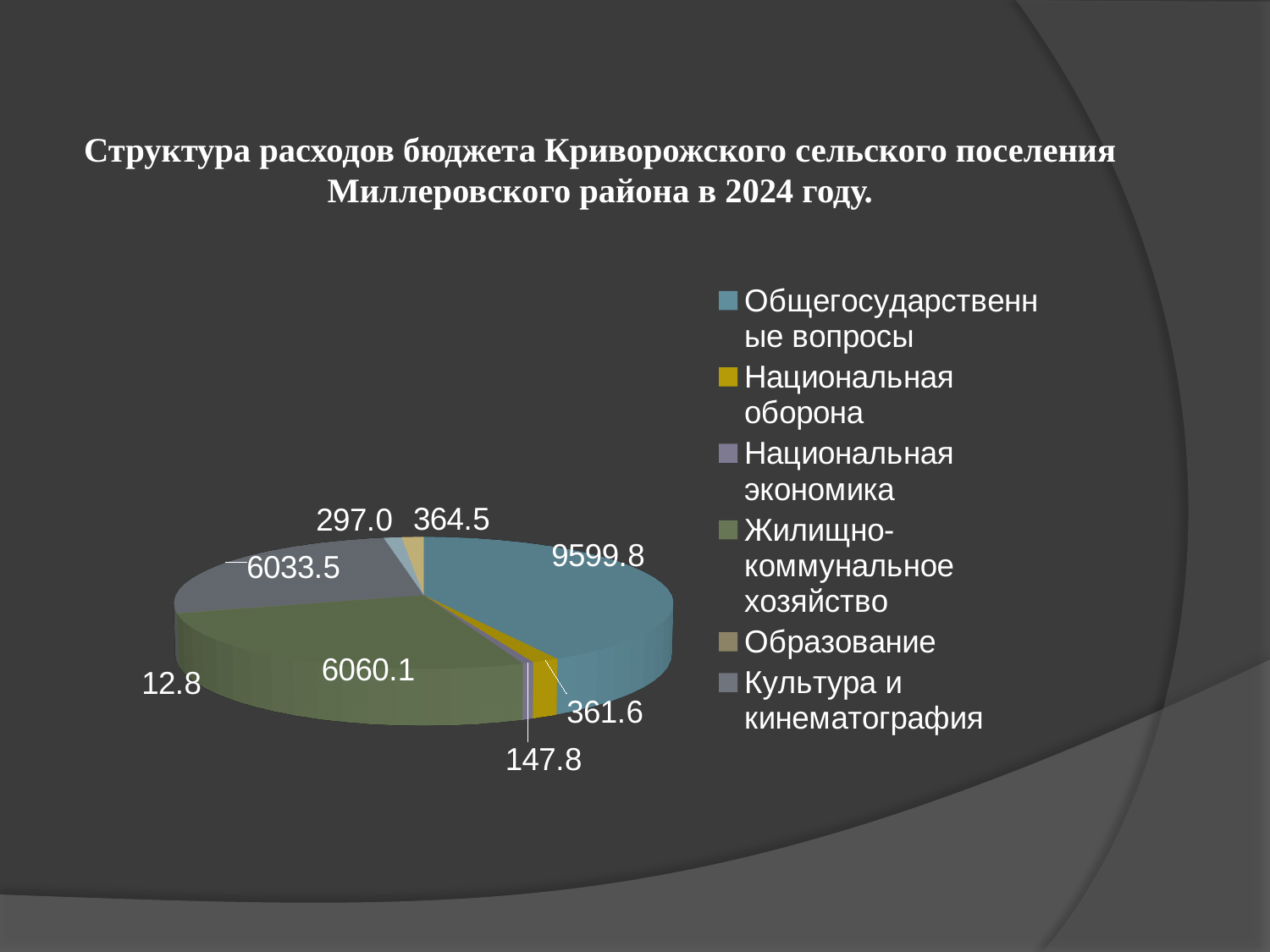
What is the value for Культура и кинематография? 6033.5 Which is larger, the value for Жилищно-коммунальное хозяйство or the value for Культура и кинематография? Жилищно-коммунальное хозяйство What type of chart is shown on the slide? Pie chart What is the value for Национальная оборона? 361.6 What is the value for Жилищно-коммунальное хозяйство? 6060.1 What is the difference between the values for Общегосударственные вопросы and Жилищно-коммунальное хозяйство? 3539.7 What is the value for Национальная экономика? 147.8 What is the value for Общегосударственные вопросы? 9599.8 How many data labels are shown on the pie chart? 8 How many entries does the legend list? 6 Which category has the largest slice of the pie? Общегосударственные вопросы What is the smallest value labelled on the pie chart? 12.8